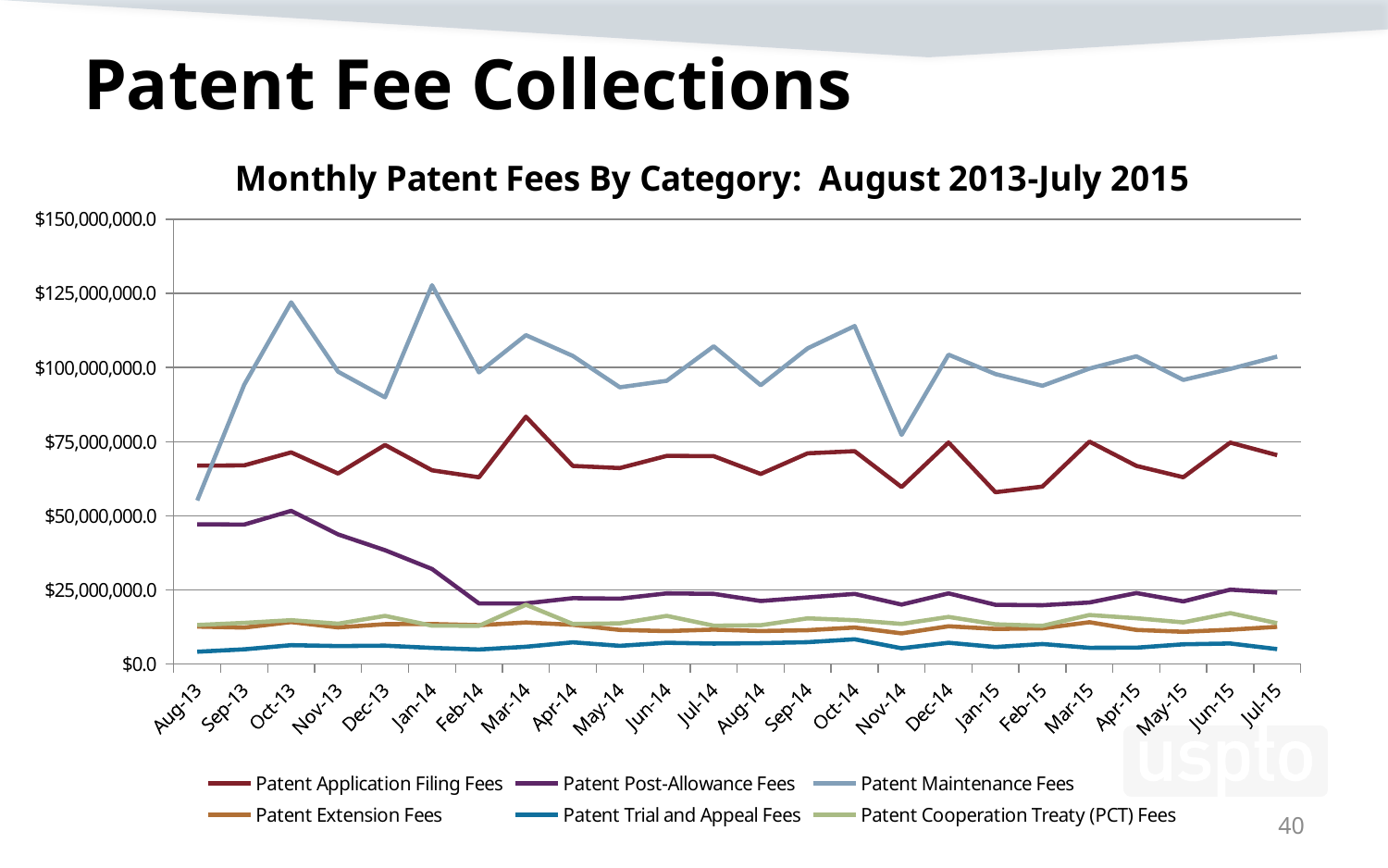
What is the title of the chart? Monthly Patent Fees By Category: August 2013-July 2015 Is the value for Patent Post-Allowance Fees in Aug-13 greater or less than $25,000,000.0? greater Is the value for Patent Application Filing Fees in Mar-14 greater or less than $75,000,000.0? greater How many series does the legend list? 6 Is the value for Patent Maintenance Fees in Jan-14 greater or less than $100,000,000.0? greater Do the values for Patent Post-Allowance Fees rise or fall from Oct-13 to Feb-14? fall What kind of chart is shown on the slide? Line chart In Jul-15, which is larger: Patent Application Filing Fees or Patent Post-Allowance Fees? Patent Application Filing Fees How many months are plotted along the x axis? 24 Which series has the highest value in Jan-14? Patent Maintenance Fees Which series has the lowest value in Jul-15? Patent Trial and Appeal Fees